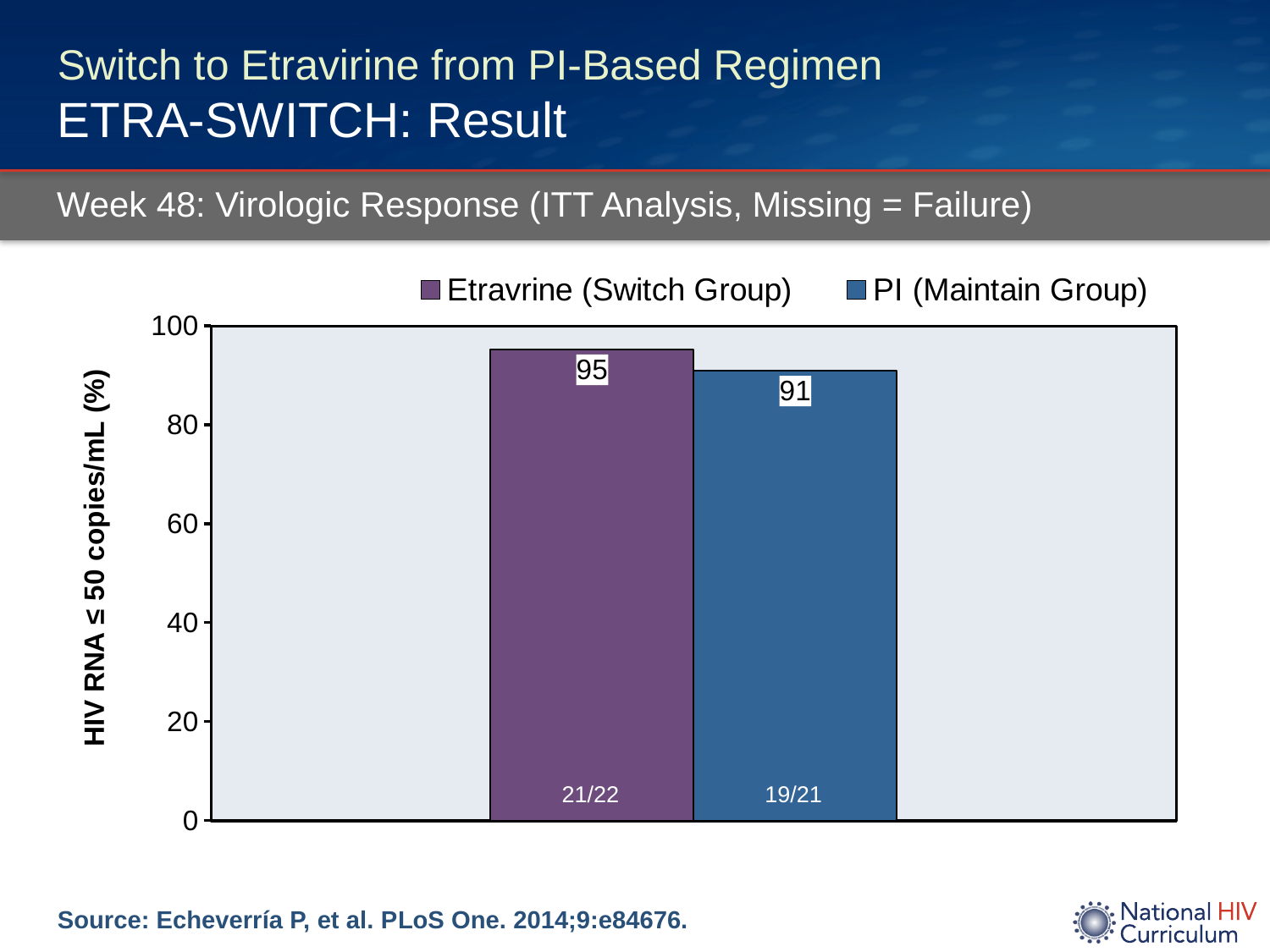
Is the value for PI (Maintain Group) greater or less than 80? greater What fraction is printed inside the PI (Maintain Group) bar? 19/21 What fraction is printed inside the Etravrine (Switch Group) bar? 21/22 What is the value for PI (Maintain Group)? 91 What kind of chart is shown? bar chart What is the value for Etravrine (Switch Group)? 95 Which group has the lower virologic response? PI (Maintain Group) What is the difference between the Etravrine (Switch Group) and PI (Maintain Group) values? 4 How many series does the legend list? 2 Is the value for Etravrine (Switch Group) larger or smaller than the value for PI (Maintain Group)? larger What is the y-axis label of the chart? HIV RNA ≤ 50 copies/mL (%) Which group has the higher virologic response? Etravrine (Switch Group)